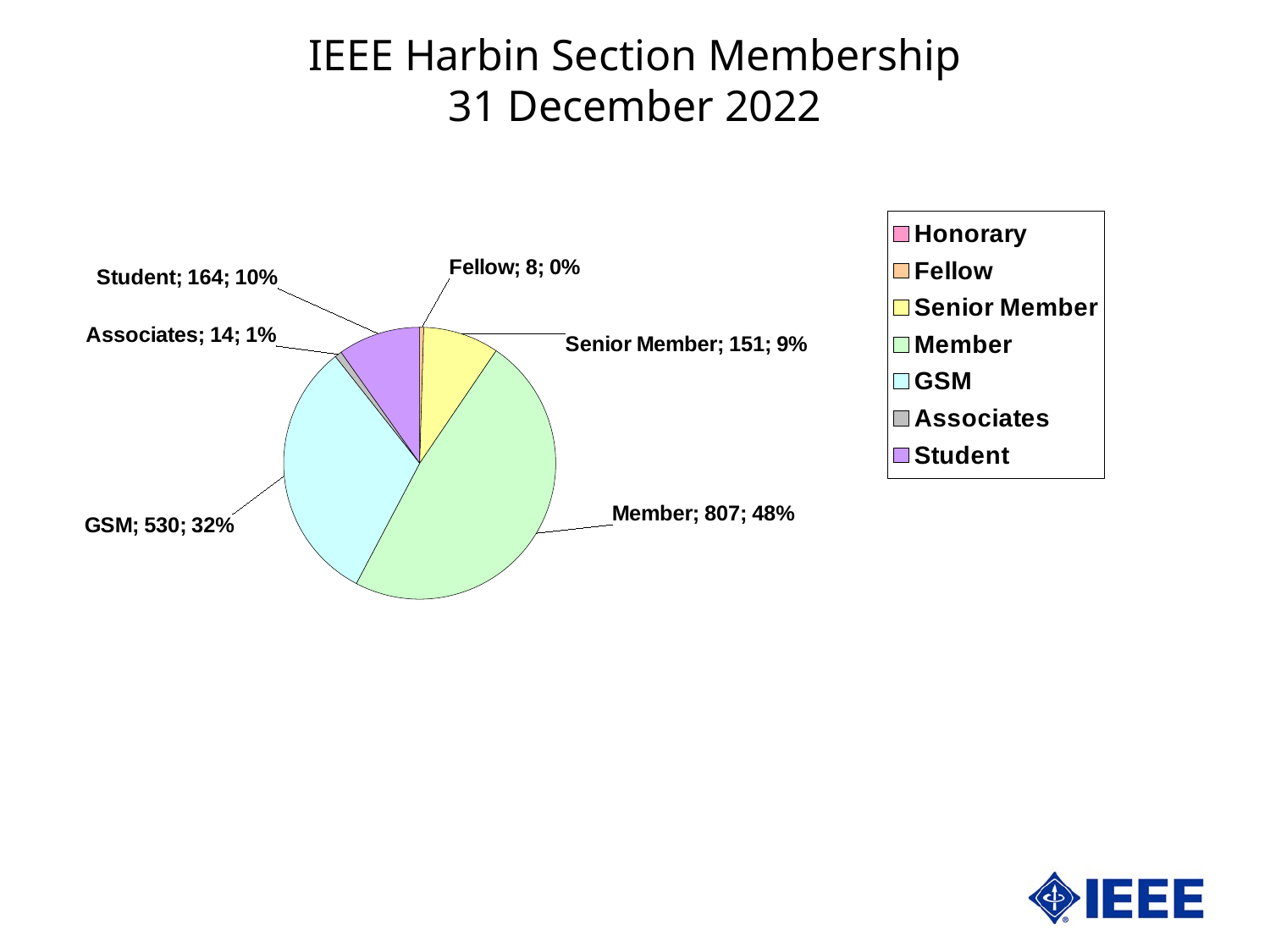
How many members are in the Member category? 807 What share of the pie does Student represent? 10% Which category has the largest slice of the pie? Member What is the title of the chart? IEEE Harbin Section Membership 31 December 2022 What is the value for GSM? 530 Which labelled category has the smallest value? Fellow How many entries does the legend list? 7 What is the value for Fellow? 8 What is the difference between the Member and GSM values? 277 What type of chart is shown on the slide? pie chart What percentage share does Senior Member have? 9% Which is larger, Student or Senior Member? Student